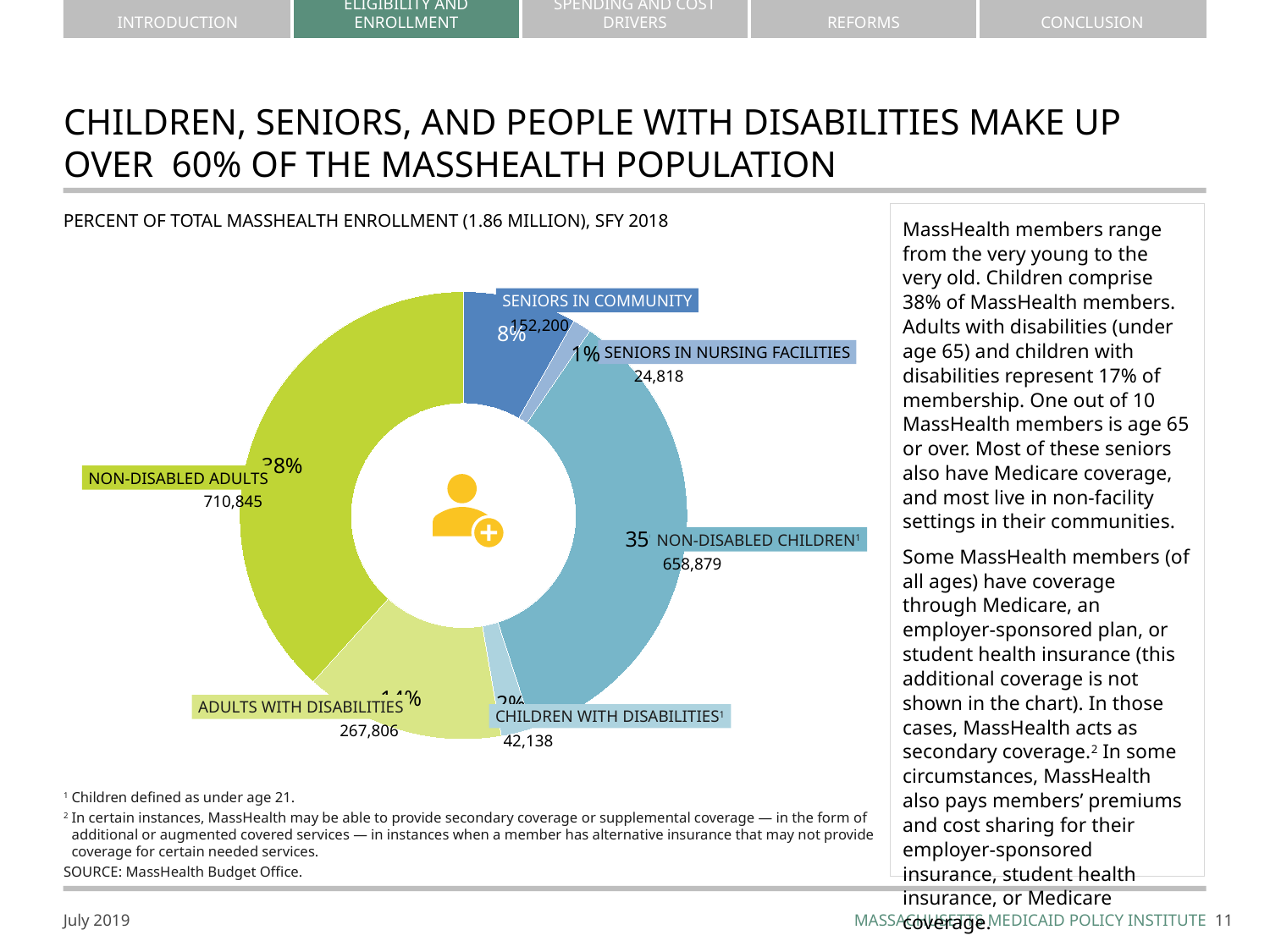
What is the enrollment value shown for Non-Disabled Adults? 710,845 What is the difference in enrollment between Non-Disabled Adults and Non-Disabled Children? 51,966 What is the enrollment value shown for Adults with Disabilities? 267,806 What is the enrollment value shown for Non-Disabled Children? 658,879 What is the enrollment value shown for Seniors in Nursing Facilities? 24,818 Which category has the smallest enrollment in the chart? Seniors in Nursing Facilities What total MassHealth enrollment is stated in the chart's subtitle? 1.86 million How many categories does the donut chart show? 6 What percent of total MassHealth enrollment do Seniors in Community represent? 8% Which category has the largest enrollment in the chart? Non-Disabled Adults Which has a larger enrollment, Adults with Disabilities or Seniors in Community? Adults with Disabilities What kind of chart is shown on the slide? Pie (donut) chart